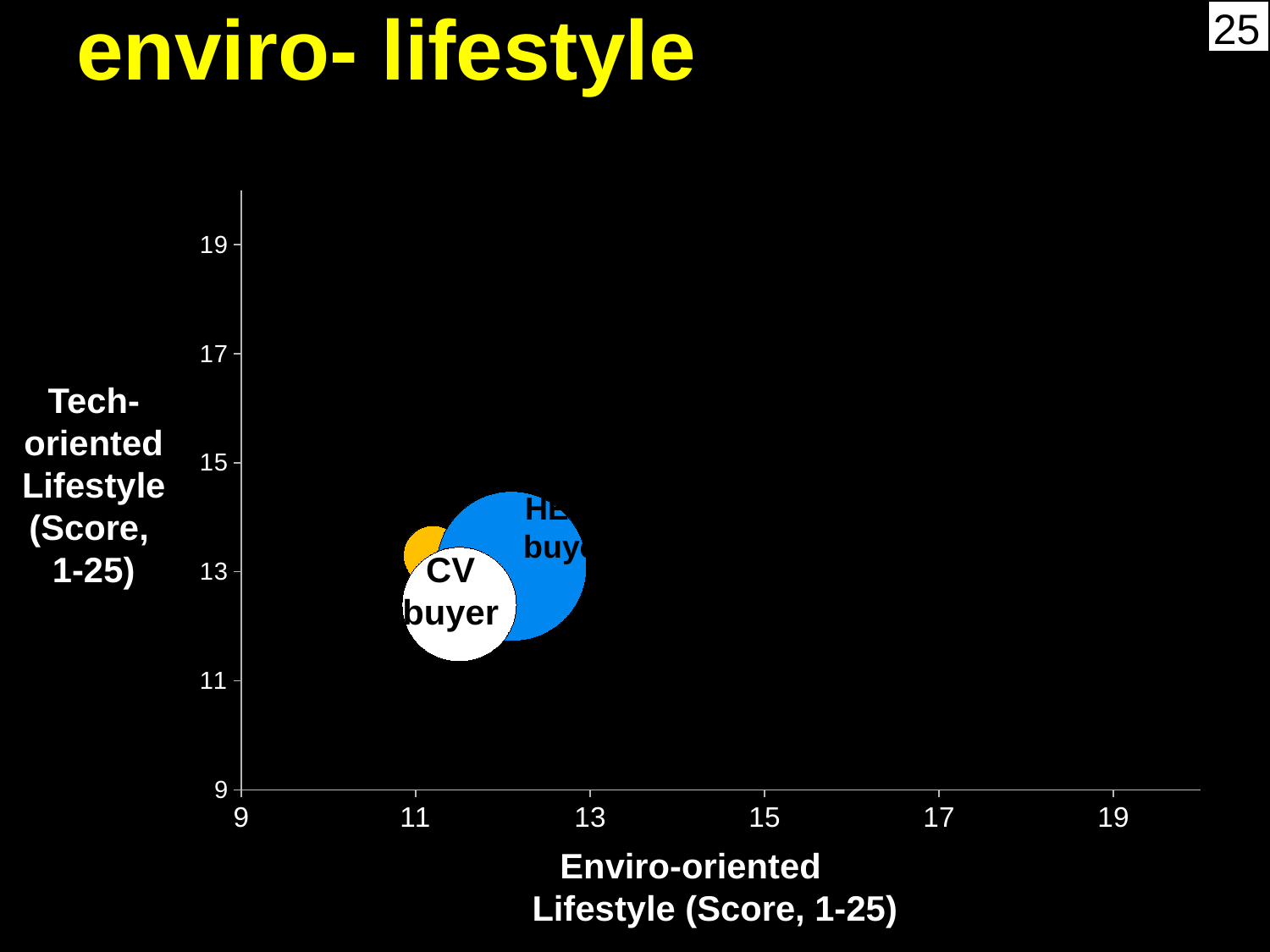
Which has the higher Tech-oriented Lifestyle score, the blue bubble or the CV buyer bubble? the blue bubble What kind of chart is shown on the slide? bubble chart What is the label of the white bubble on the chart? CV buyer What is the title of the horizontal axis of the chart? Enviro-oriented Lifestyle (Score, 1-25) Is the Enviro-oriented Lifestyle score for CV buyer greater or less than 9? greater How many bubbles are plotted on the chart? 3 Is the Enviro-oriented Lifestyle score for the blue bubble greater or less than 15? less Is the Tech-oriented Lifestyle score for CV buyer greater or less than 11? greater Which has the higher Enviro-oriented Lifestyle score, the blue bubble or the CV buyer bubble? the blue bubble